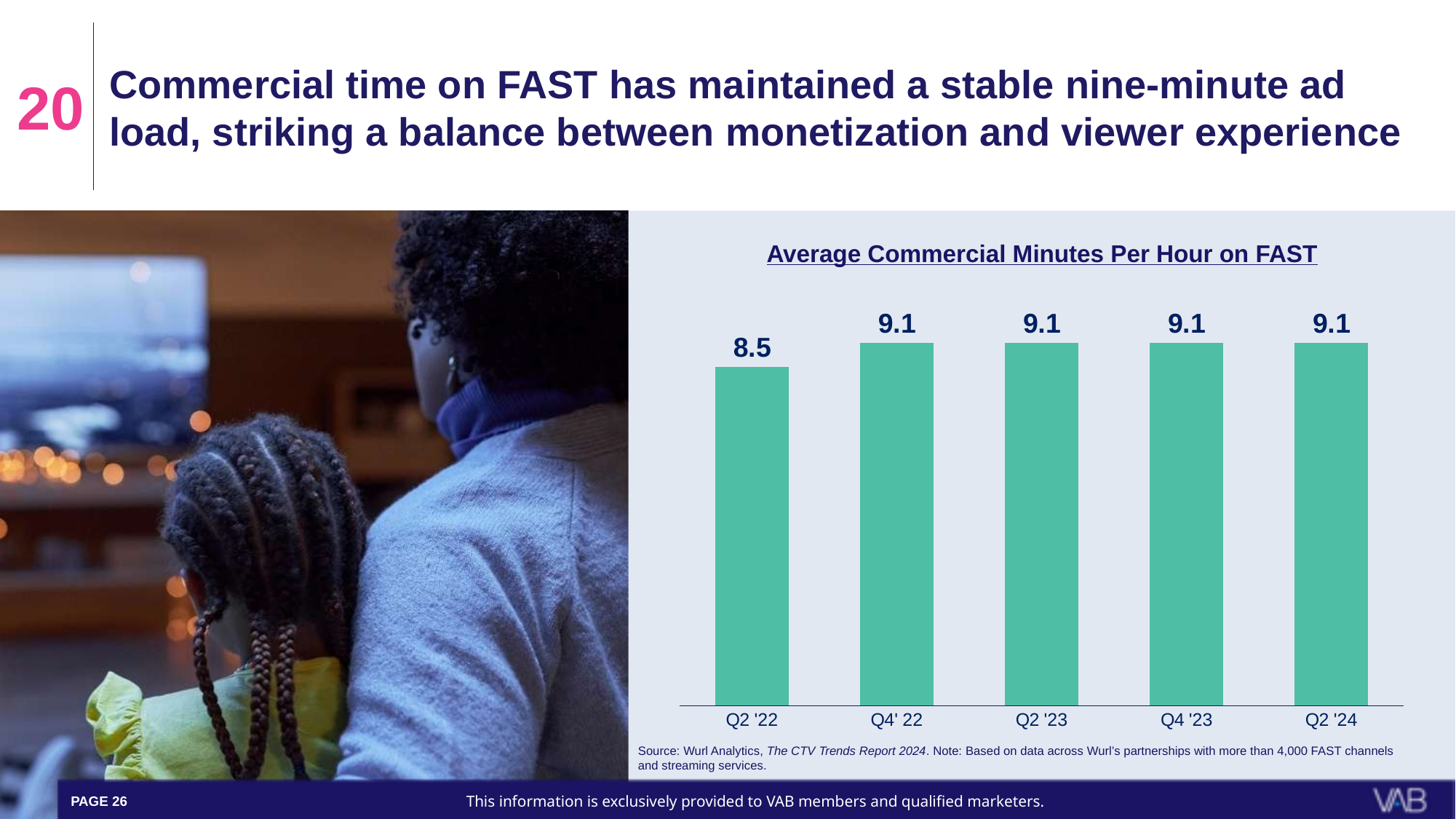
What is the value for Q2 '24? 9.1 What colour are the bars in the chart? Green Do the values rise or fall from Q2 '22 to Q4' 22? Rise What is the difference between the values for Q4' 22 and Q2 '22? 0.6 What kind of chart is shown? Bar chart What is the value for Q2 '22? 8.5 How many categories are shown on the x axis? 5 What is the title of the chart? Average Commercial Minutes Per Hour on FAST Which is larger, the value for Q2 '22 or the value for Q2 '23? Q2 '23 Which category has the lowest value? Q2 '22 What is the value for Q4 '23? 9.1 Do the values change from Q4' 22 to Q2 '24? No, they stay at 9.1